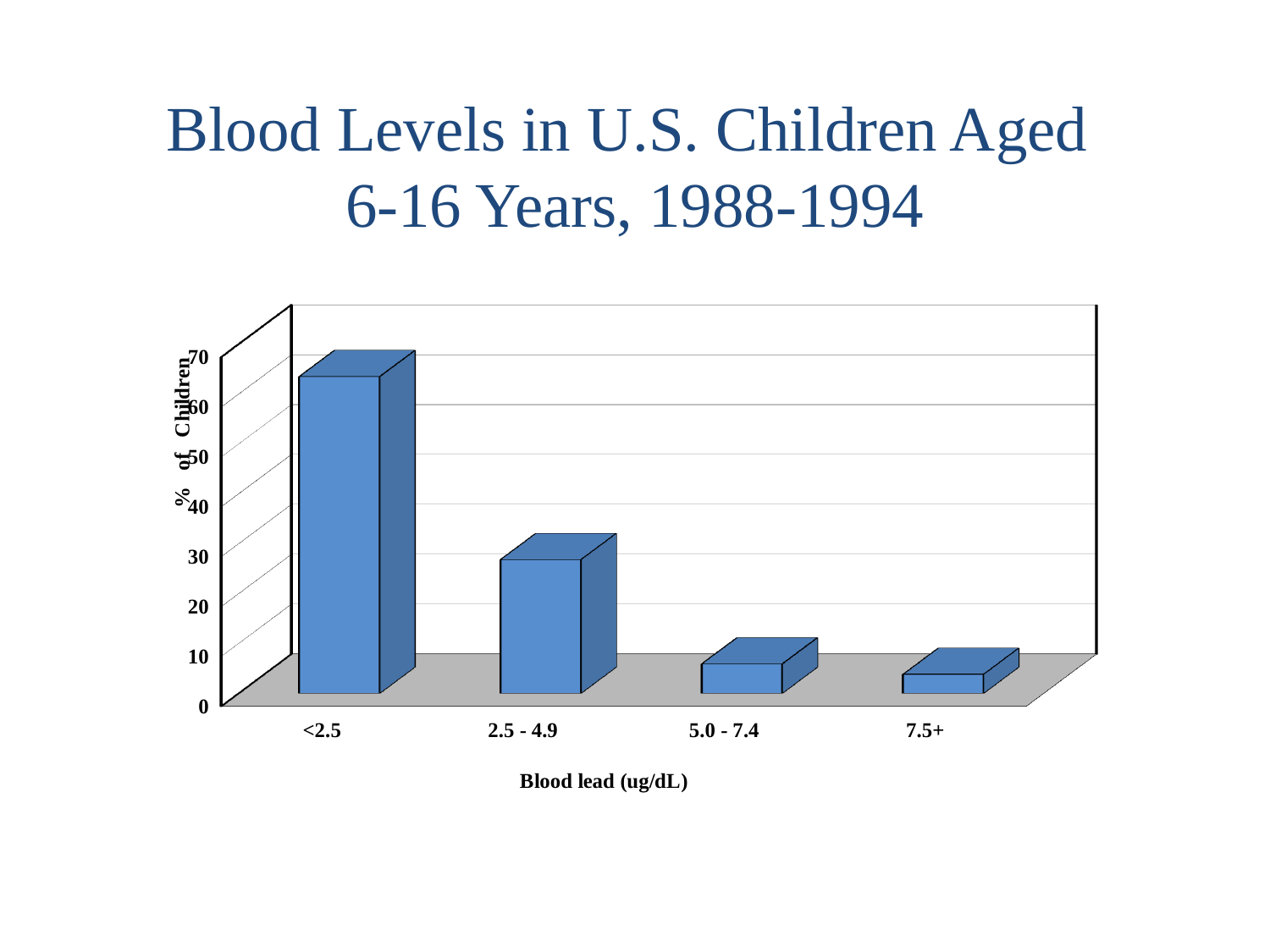
What is the title of the slide? Blood Levels in U.S. Children Aged 6-16 Years, 1988-1994 Which blood lead category has the highest percentage of children? <2.5 What kind of chart is shown on the slide? bar chart Is the value for the <2.5 category greater or less than 50? greater Is the value for the 7.5+ category greater or less than 20? less Which is larger, the value for <2.5 or the value for 2.5 - 4.9? <2.5 Is the value for the 5.0 - 7.4 category greater or less than 20? less Do the values rise or fall as you move from left to right along the x axis? fall Which is larger, the value for 2.5 - 4.9 or the value for 7.5+? 2.5 - 4.9 How many blood lead categories are shown on the x axis? 4 What is the label of the x axis? Blood lead (ug/dL)